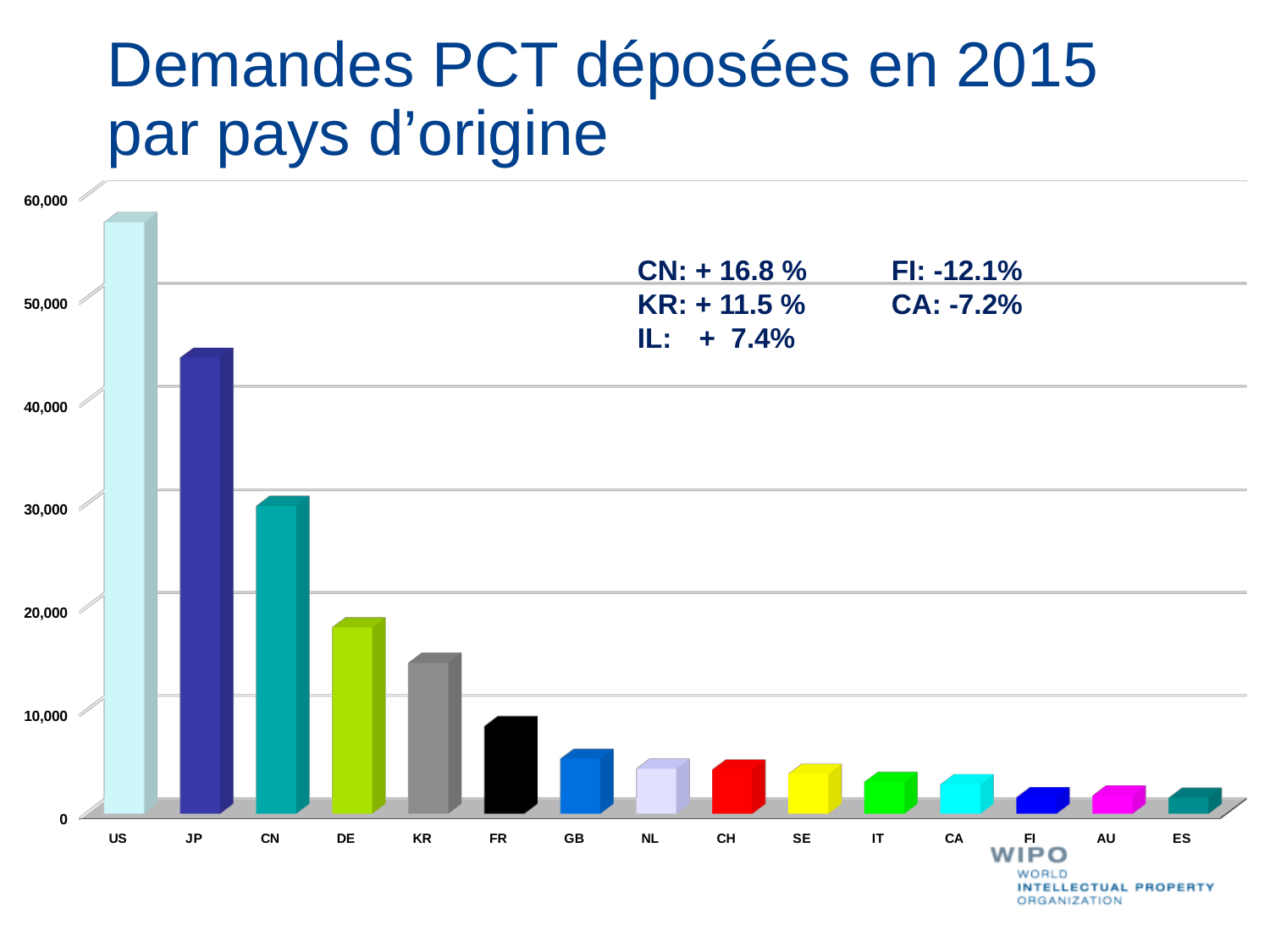
What percentage change is shown for KR in the text annotation on the chart? + 11.5 % Is the value for DE greater or less than 20,000? less Do the values rise or fall moving from left to right along the x axis? fall Which has the larger value, DE or KR? DE How many countries are shown on the x axis of the chart? 15 Is the value for US greater or less than 50,000? greater Which country has the highest number of PCT applications in the chart? US Is the value for JP greater or less than 40,000? greater What kind of chart is shown on the slide? bar chart Which country has the lowest number of PCT applications in the chart? ES Which has the larger value, JP or CN? JP